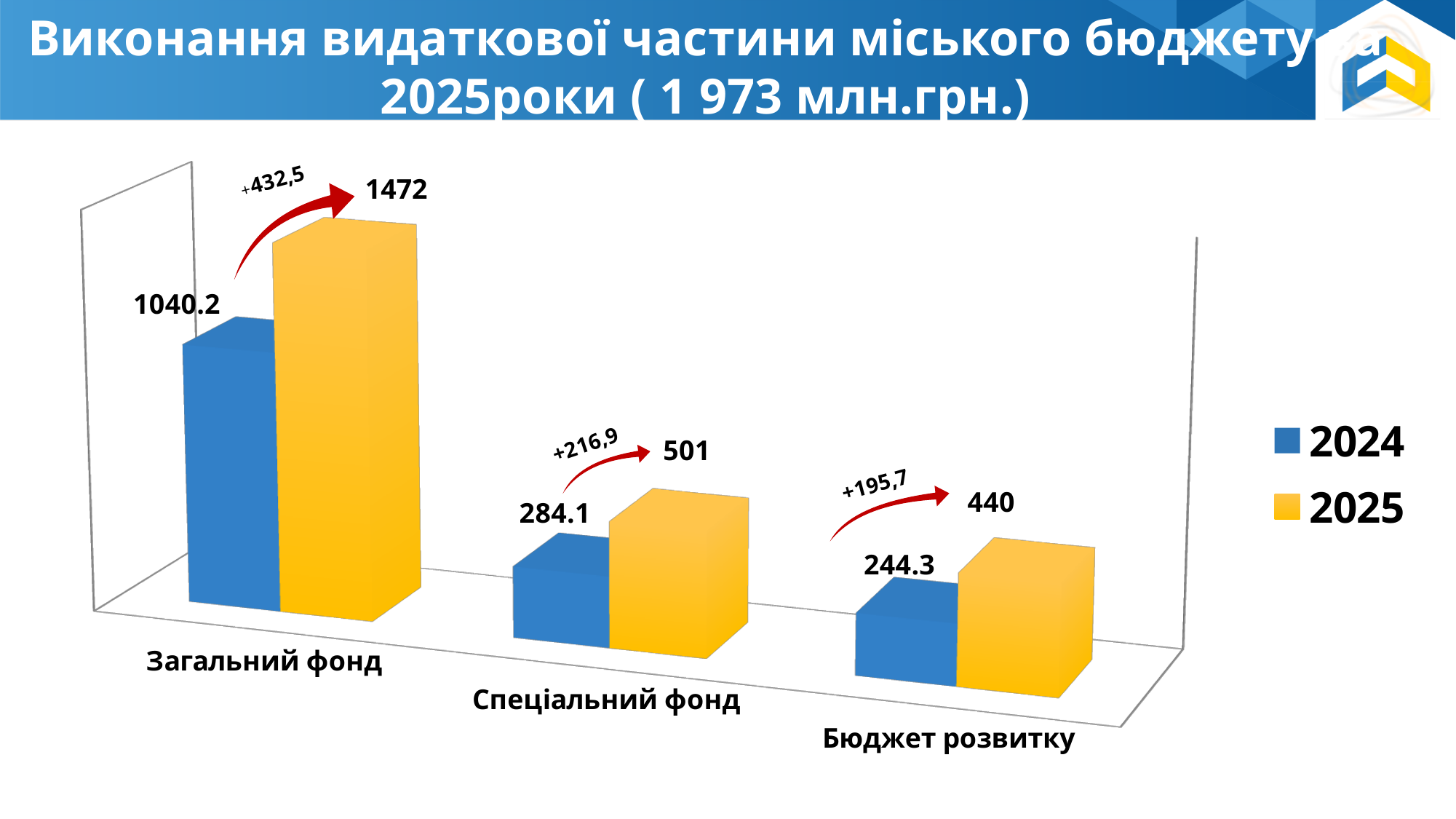
Which category has the highest 2025 value? Загальний фонд What is the 2025 value for Бюджет розвитку? 440 Which colour represents the 2025 series in the legend? Yellow What is the 2025 value for Загальний фонд? 1472 How many series does the legend list? 2 What is the 2024 value for Загальний фонд? 1040.2 How many categories are shown on the x axis? 3 What is the 2024 value for Спеціальний фонд? 284.1 Which category has the lowest 2024 value? Бюджет розвитку Which is larger: the 2025 value for Спеціальний фонд or the 2025 value for Бюджет розвитку? 2025 value for Спеціальний фонд What is the difference between the 2025 and 2024 values for Спеціальний фонд? 216.9 What kind of chart is shown on the slide? Bar chart